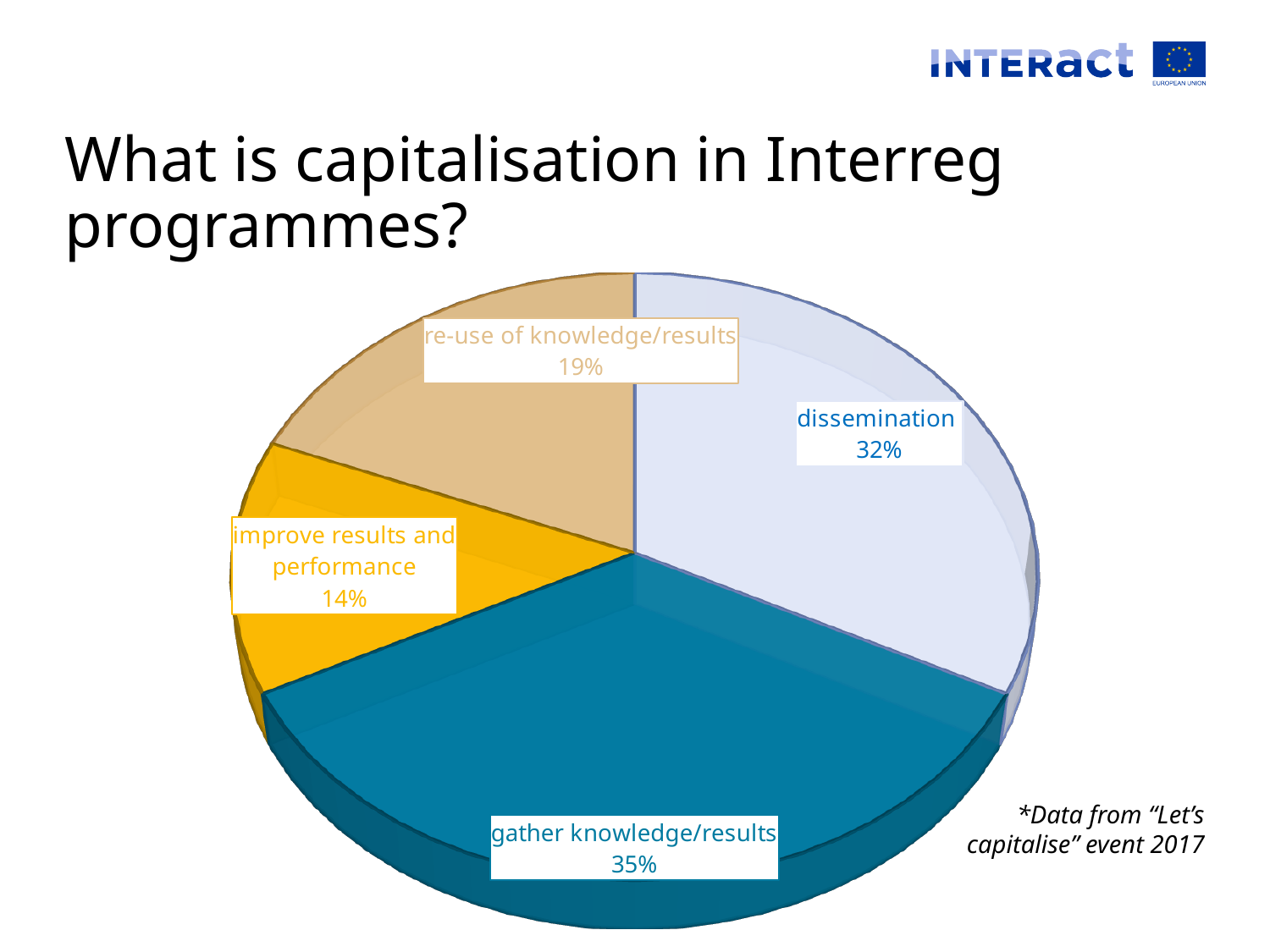
What colour is the "gather knowledge/results" slice? teal blue What share of the pie does "dissemination" have? 32% Which is larger, the share for "dissemination" or the share for "re-use of knowledge/results"? dissemination What kind of chart is shown on the slide? pie chart What share of the pie does "gather knowledge/results" have? 35% What share of the pie does "improve results and performance" have? 14% What share of the pie does "re-use of knowledge/results" have? 19% Which slice of the pie is the smallest? improve results and performance How many slices does the pie chart have? 4 What is the difference in percentage points between "gather knowledge/results" and "dissemination"? 3 What is the difference in percentage points between "re-use of knowledge/results" and "improve results and performance"? 5 Which slice of the pie is the largest? gather knowledge/results